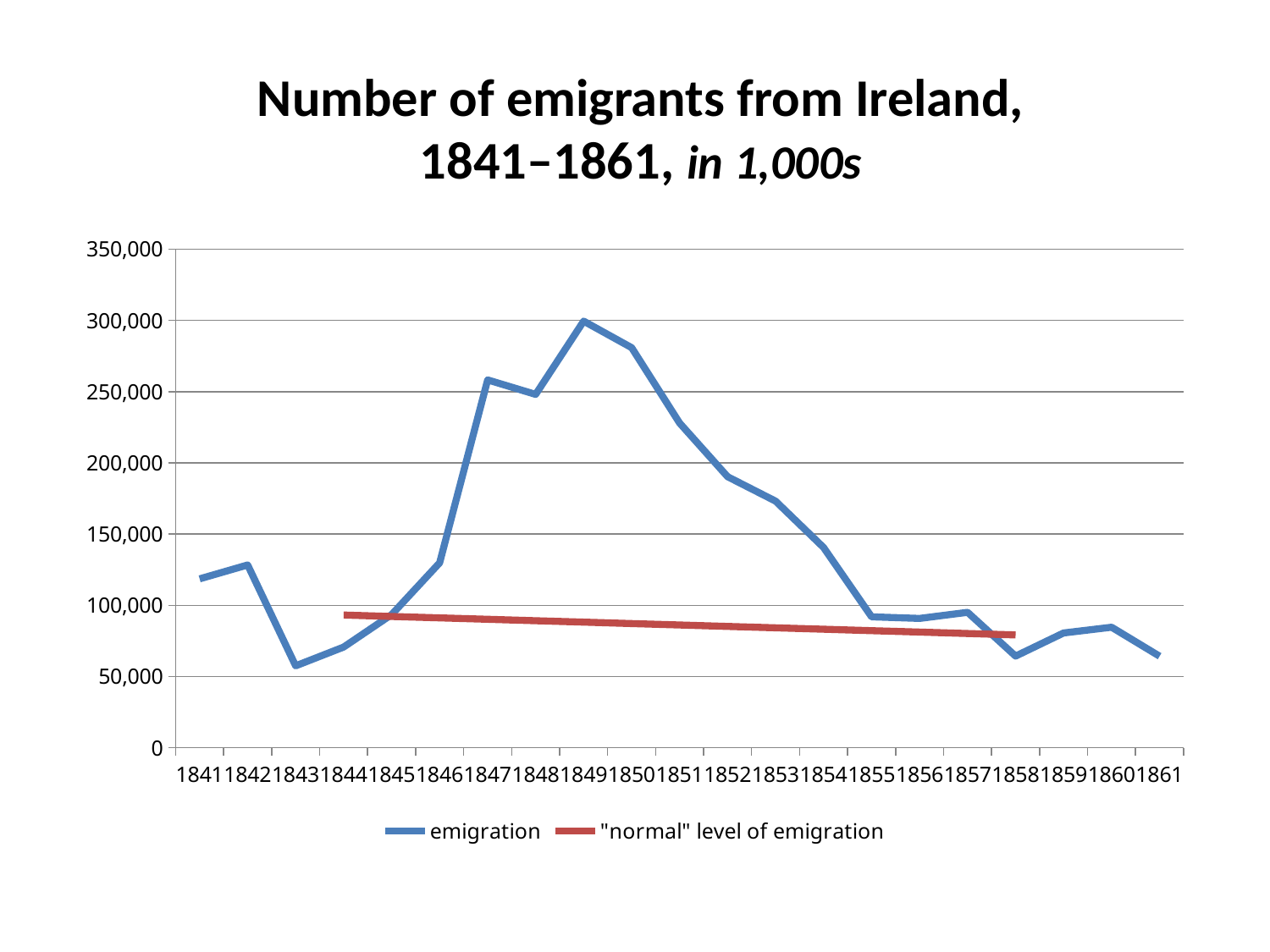
Is the emigration value for 1843 greater or less than 100,000? less Which year has the higher emigration value, 1853 or 1854? 1853 What colour is the line for the "normal" level of emigration? red Which year has the higher emigration value, 1849 or 1850? 1849 Is the emigration value for 1849 greater or less than 250,000? greater What kind of chart is shown on the slide? line chart Is the emigration value for 1852 greater or less than 150,000? greater How many series does the legend list? 2 How many years are plotted along the x axis? 21 Does the emigration line rise or fall between 1849 and 1855? fall In which year does the emigration line reach its highest value? 1849